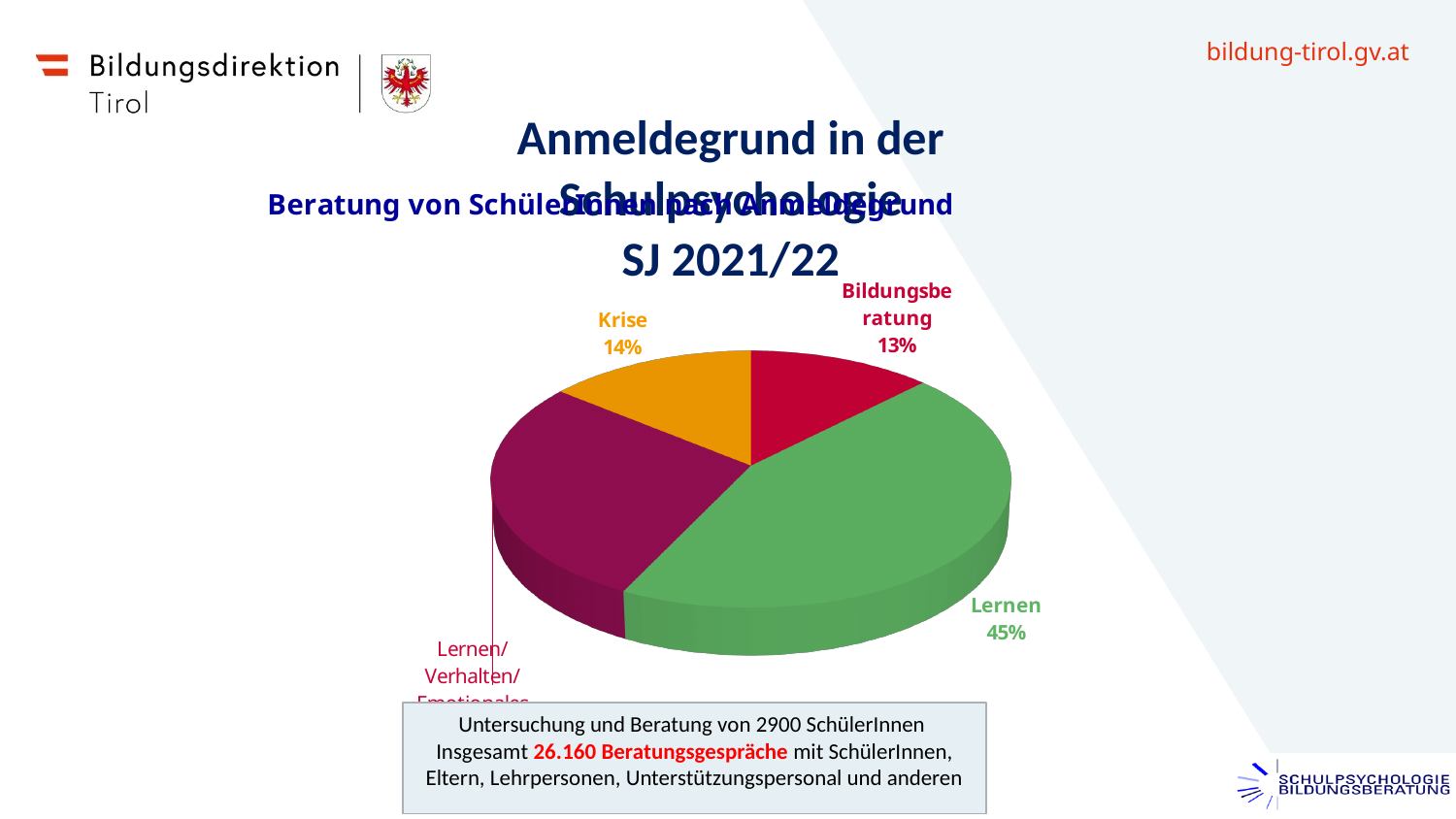
What is the difference in percentage points between Lernen and Krise? 31 What colour is the Lernen slice of the pie? green What is the value shown for Bildungsberatung? 13% What is the difference in percentage points between Krise and Bildungsberatung? 1 What colour is the Krise slice of the pie? orange How many slices does the pie chart have? 4 What share of the pie does Lernen account for? 45% What kind of chart is shown on the slide? pie chart Which of the labelled categories has the smallest printed percentage? Bildungsberatung What is the value shown for Krise? 14% Which is larger, the share for Lernen or the share for Bildungsberatung? Lernen Which category has the largest slice of the pie? Lernen